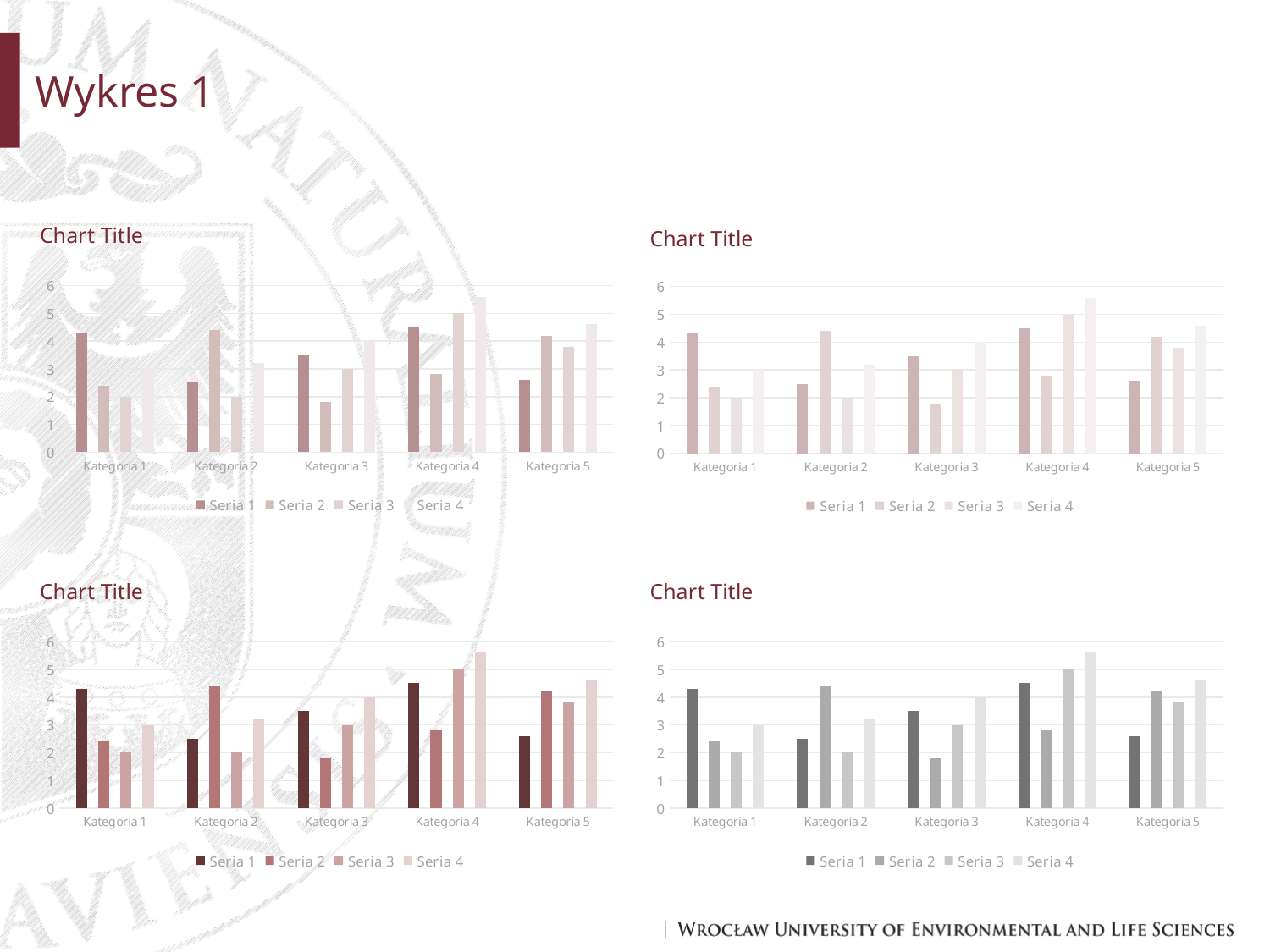
How many series does the legend of the bottom-left chart list? 4 What is the title of the bottom-right chart? Chart Title What kind of chart is the top-left chart on the slide? bar chart What is the highest value shown on the y axis of the top-left chart? 6 In the bottom-left chart, is the value for Seria 2 in Kategoria 3 greater or less than 3? less In the bottom-left chart, is the value for Seria 4 in Kategoria 4 greater or less than 5? greater In the bottom-right chart, which series has the tallest bar in Kategoria 4? Seria 4 In the top-left chart, which is larger in Kategoria 1: Seria 1 or Seria 2? Seria 1 In the top-right chart, is the value for Seria 1 in Kategoria 1 greater or less than 4? greater In the bottom-right chart, which is larger in Kategoria 2: Seria 2 or Seria 3? Seria 2 In the top-right chart, which category has the highest bar overall? Kategoria 4 How many categories are shown on the x axis of the top-right chart? 5